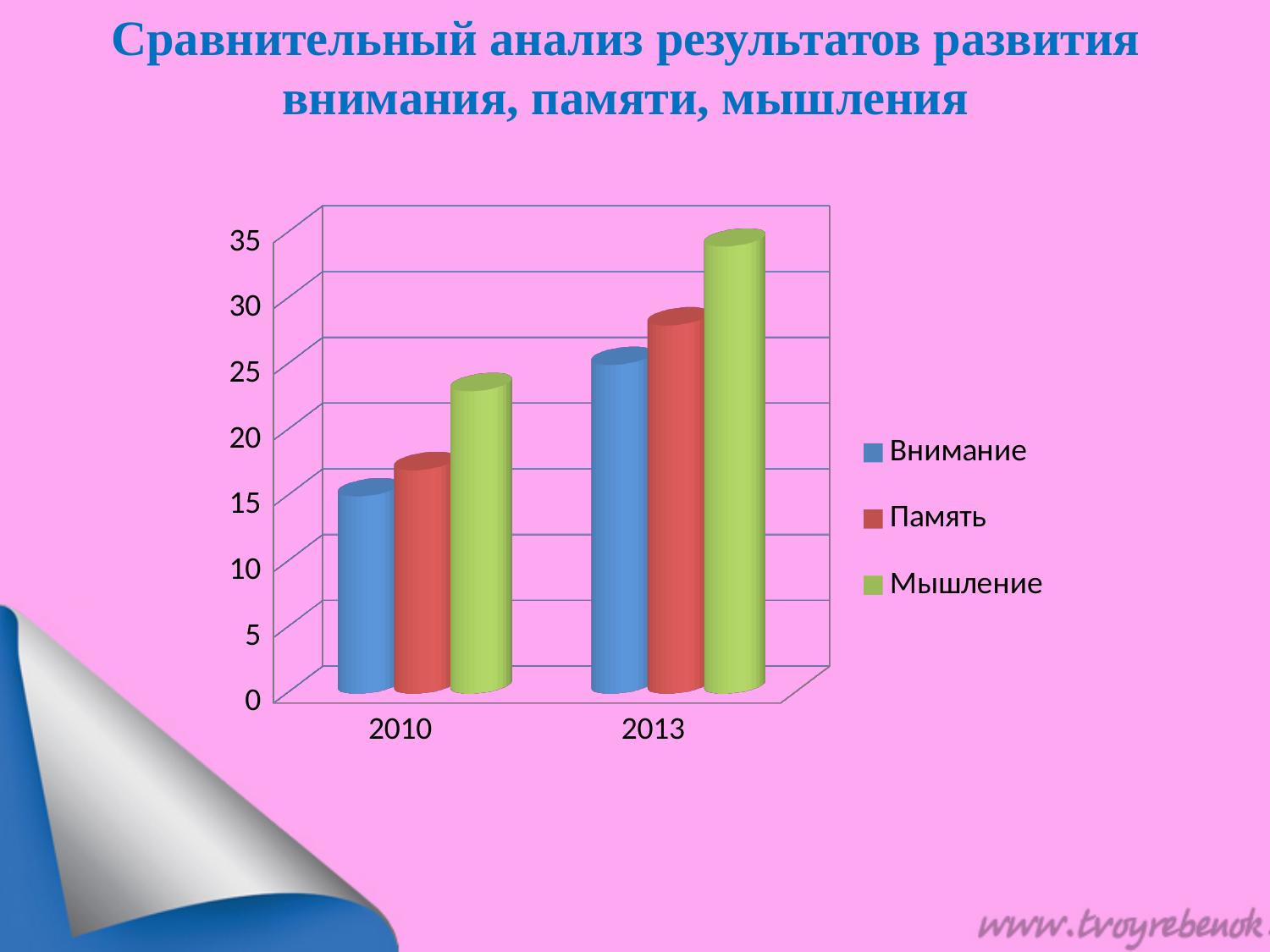
Which is larger: Память in 2010 or Память in 2013? Память in 2013 Do the values for Внимание rise or fall from 2010 to 2013? rise Which series has the lowest value in 2010? Внимание How many categories are shown on the x axis? 2 Is the value for Мышление in 2013 greater or less than 30? greater Is the value for Память in 2013 greater or less than 25? greater Which colour represents the series Мышление in the legend? green How many series does the legend list? 3 Is the value for Внимание in 2010 greater or less than 20? less What kind of chart is shown on the slide? bar chart Which series has the highest value in 2013? Мышление